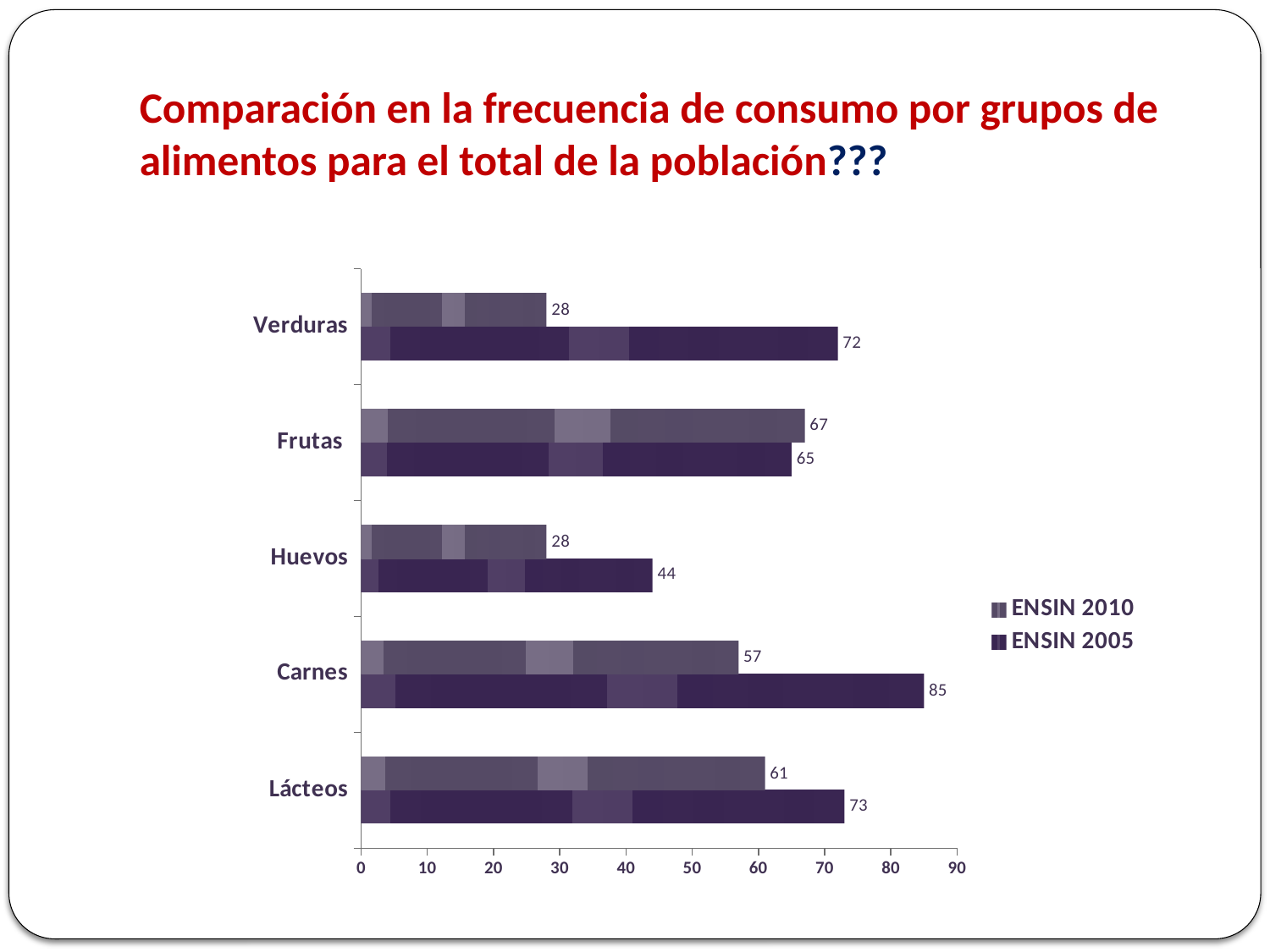
What is the ENSIN 2005 value for Carnes? 85 What is the ENSIN 2005 value for Huevos? 44 How many series does the legend list? 2 Which food group has the lowest ENSIN 2005 value? Huevos Which food group has the highest ENSIN 2005 value? Carnes How many food groups are shown on the chart? 5 What kind of chart is shown on the slide? Bar chart What is the difference between the ENSIN 2005 and ENSIN 2010 values for Verduras? 44 What are the two series named in the legend? ENSIN 2010 and ENSIN 2005 Which is larger for Lácteos, the ENSIN 2010 value or the ENSIN 2005 value? ENSIN 2005 What is the ENSIN 2010 value for Frutas? 67 What is the ENSIN 2010 value for Verduras? 28